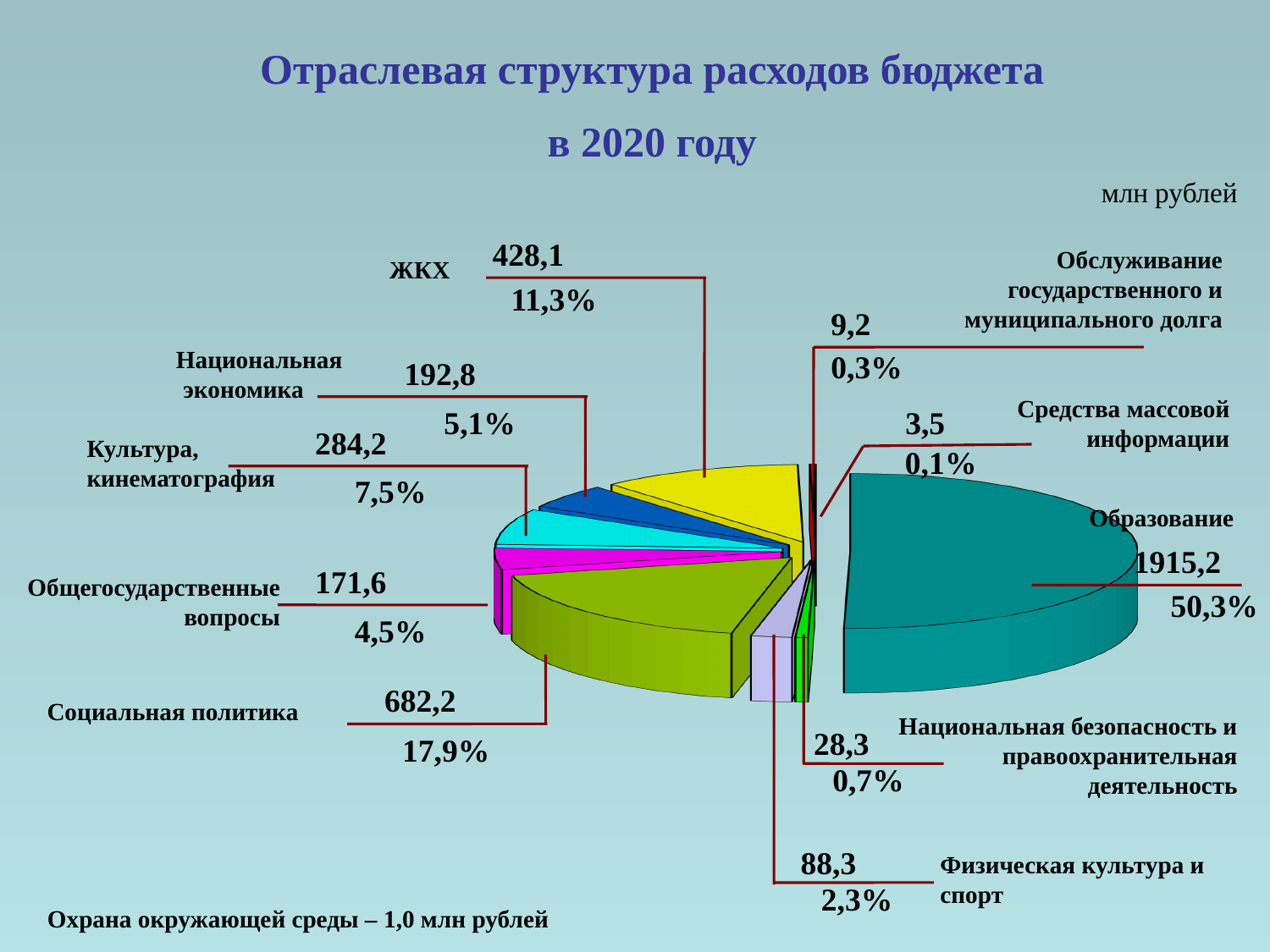
What share of the budget expenditures does Социальная политика account for? 17,9% What is the value for Образование (in млн рублей)? 1915,2 What is the value for Физическая культура и спорт (in млн рублей)? 88,3 In what units are the values on the chart given? млн рублей Which is larger: the value for Национальная экономика or the value for Культура, кинематография? Культура, кинематография What type of chart is shown on the slide? pie chart What percentage share is shown for Культура, кинематография? 7,5% What is the difference between the values for Социальная политика and ЖКХ (in млн рублей)? 254,1 What is the value for ЖКХ (in млн рублей)? 428,1 What is the title of the chart? Отраслевая структура расходов бюджета в 2020 году Which category has the largest share of budget expenditures? Образование Which labeled slice has the smallest share of budget expenditures? Средства массовой информации